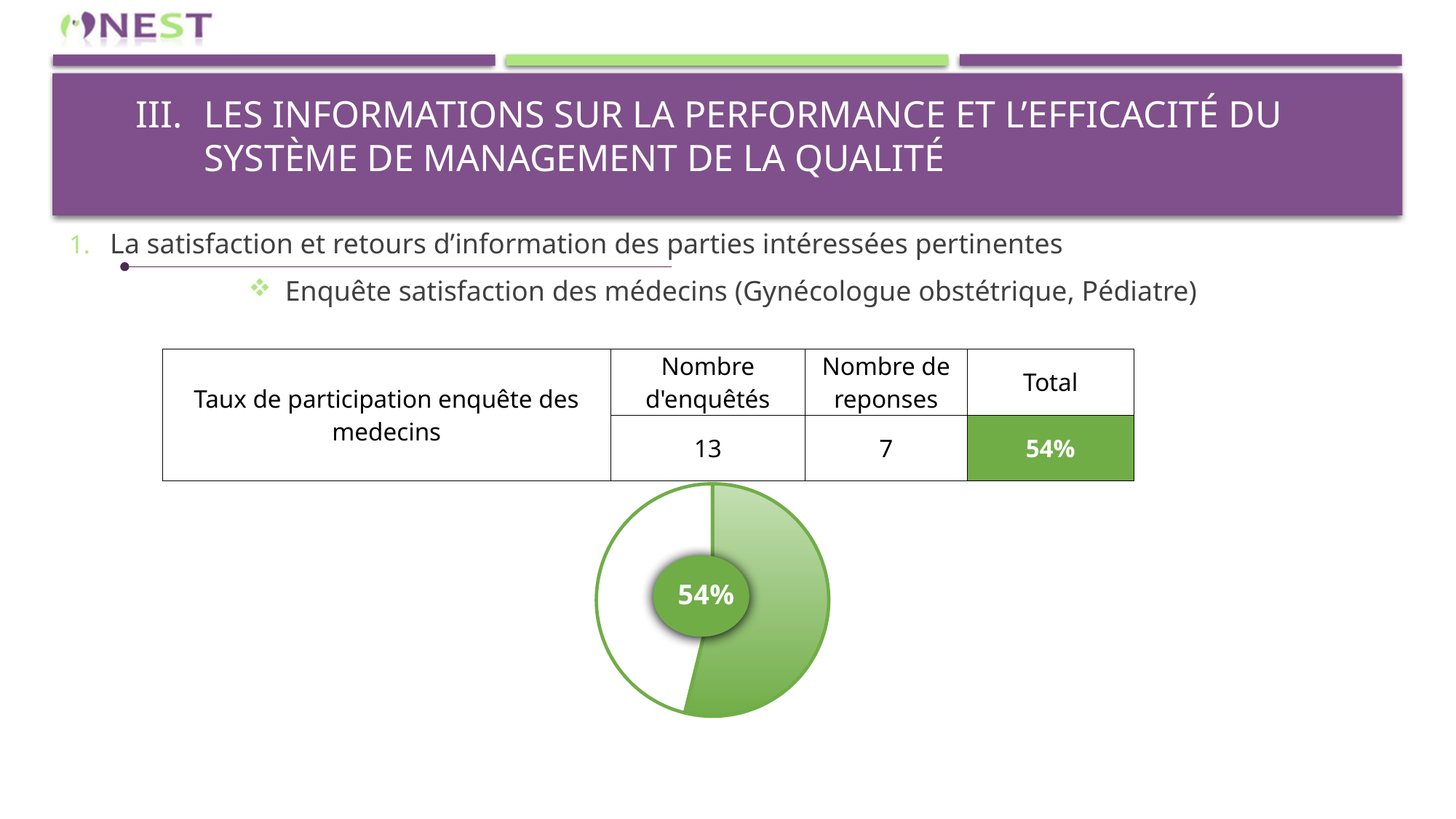
Which slice of the pie chart is larger, the green slice or the white slice? the green slice What colour is the slice of the pie chart that carries the 54% label? green Is the share of the green slice in the pie chart greater or less than 50%? greater How many slices does the pie chart have? 2 How many data labels are printed on the pie chart? 1 What percentage is shown on the labelled slice of the pie chart? 54% What kind of chart is shown on the slide? pie chart Does the pie chart's 54% label match the Total value in the table above it? yes